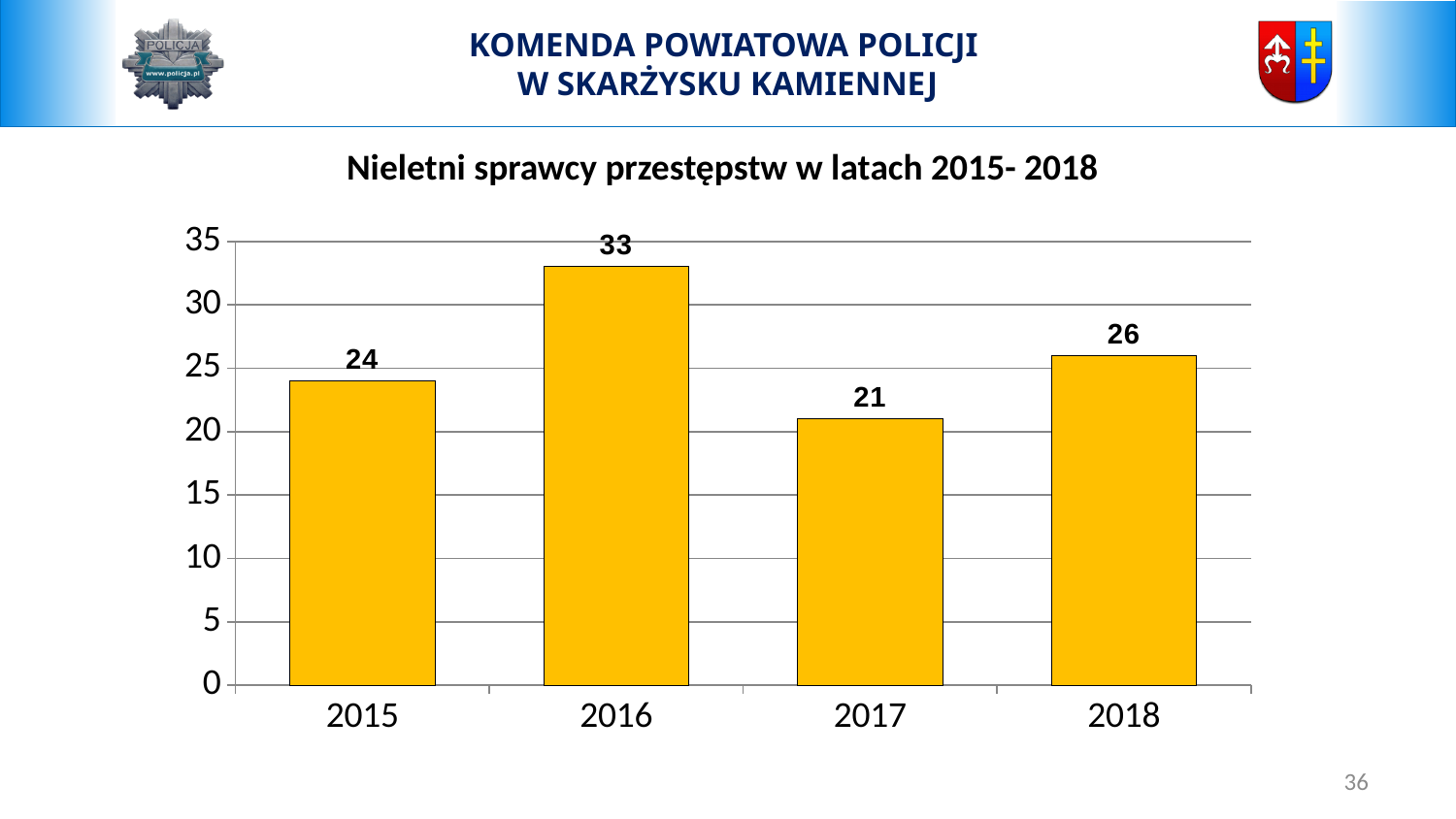
Which year has the lowest value? 2017 What is the value for 2015? 24 Which is larger, the value for 2015 or the value for 2018? 2018 What is the difference between the values for 2016 and 2017? 12 What kind of chart is shown on the slide? bar chart How many years are shown on the x axis? 4 What is the value for 2016? 33 What is the value for 2018? 26 What is the title of the chart? Nieletni sprawcy przestępstw w latach 2015- 2018 What is the value for 2017? 21 Which year has the highest value? 2016 Is the value for 2016 greater or less than 30? greater